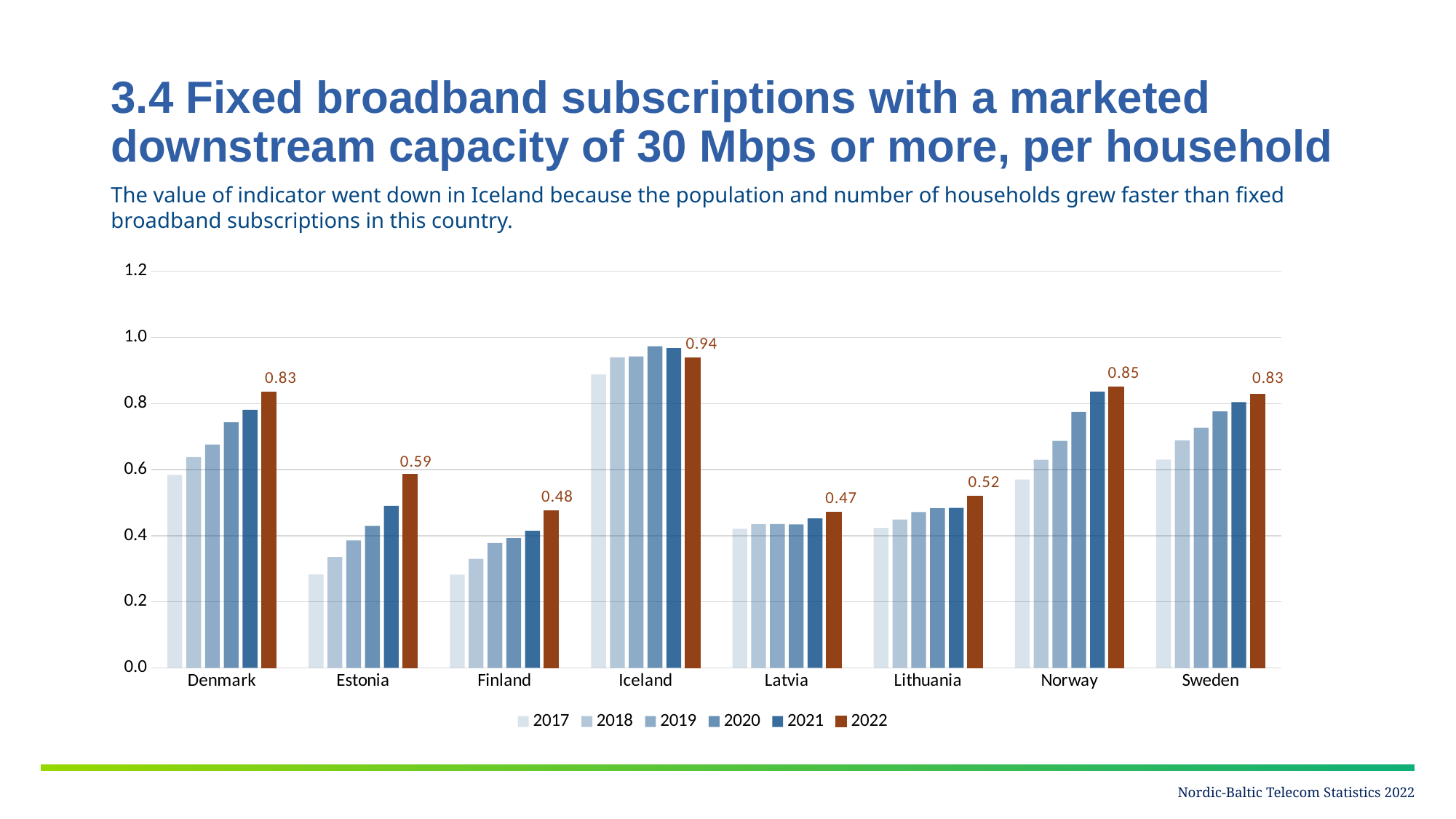
What is the value for Iceland in 2022? 0.94 What is the value for Lithuania in 2022? 0.52 Which is larger in 2022, the value for Estonia or the value for Lithuania? Estonia How many series does the legend list? 6 What is the difference between the 2022 values for Norway and Denmark? 0.02 How many countries are shown on the x axis? 8 Which country has the highest value in 2022? Iceland Is the value for Iceland in 2017 greater or less than 0.8? greater Do the values for Denmark rise or fall from 2017 to 2022? rise What is the value for Estonia in 2022? 0.59 Is the value for Denmark in 2017 greater or less than 0.6? less What is the difference between the 2022 values for Iceland and Latvia? 0.47